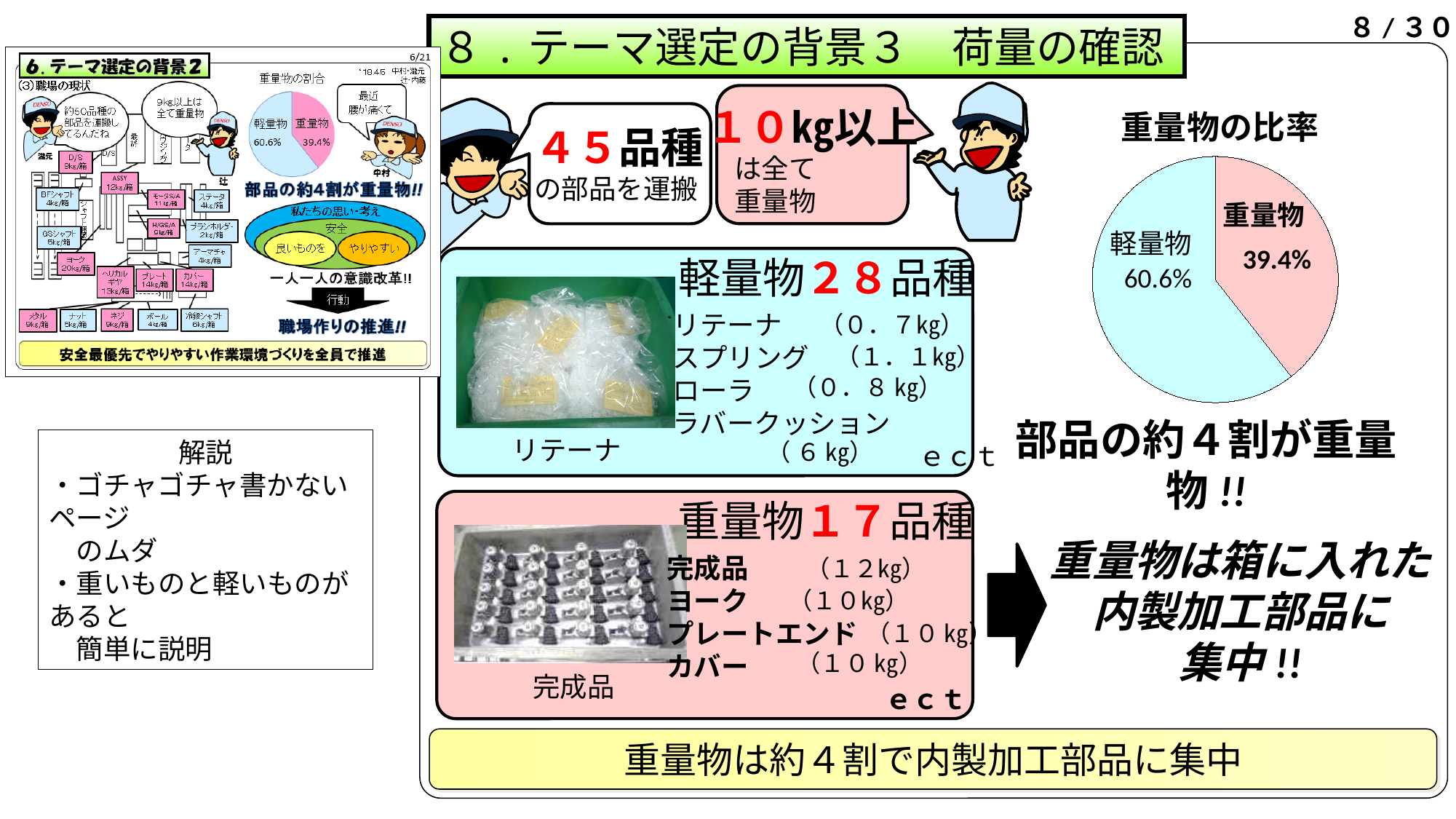
What is the title of the pie chart on the right side of the slide? 重量物の比率 In the pie chart titled 重量物の比率, which slice is the largest? 軽量物 In the pie chart titled 重量物の比率, is the share for 重量物 greater or less than 50%? less In the pie chart titled 重量物の比率, how many slices does the pie have? 2 What kind of chart is the chart titled 重量物の比率 on the right of the slide? pie chart In the pie chart titled 重量物の比率, what is the difference in percentage points between the 軽量物 share and the 重量物 share? 21.2 In the pie chart titled 重量物の比率, what share is shown for 重量物? 39.4% In the small pie chart titled 重量物の割合 inside the thumbnail image at the top left, what share is shown for 重量物? 39.4% In the pie chart titled 重量物の比率, what colour is the 重量物 slice? pink In the pie chart titled 重量物の比率, what share is shown for 軽量物? 60.6% In the pie chart titled 重量物の比率, which is larger, the share for 軽量物 or the share for 重量物? 軽量物 In the pie chart titled 重量物の比率, which slice is the smallest? 重量物